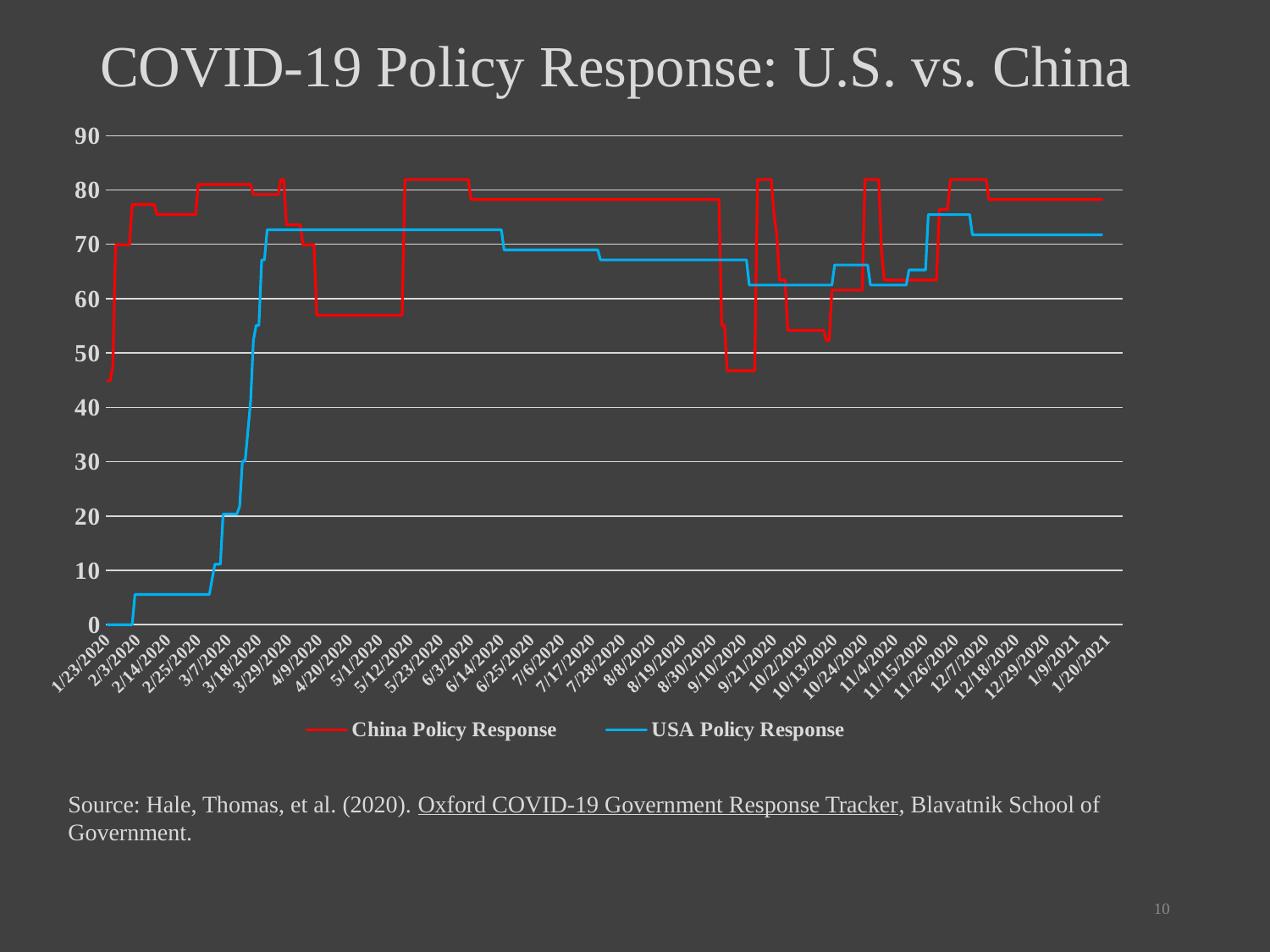
Is the China Policy Response value on 1/23/2020 greater or less than 50? less How many series does the legend list? 2 What is the title of the chart? COVID-19 Policy Response: U.S. vs. China What colour is the line for USA Policy Response? blue Is the USA Policy Response value on 3/7/2020 greater or less than 30? less Is the USA Policy Response value on 2/14/2020 greater or less than 10? less On 2/14/2020, which series has the higher value, China Policy Response or USA Policy Response? China Policy Response What kind of chart is shown on the slide? line chart Does the USA Policy Response line rise or fall between 1/23/2020 and 3/29/2020? rise